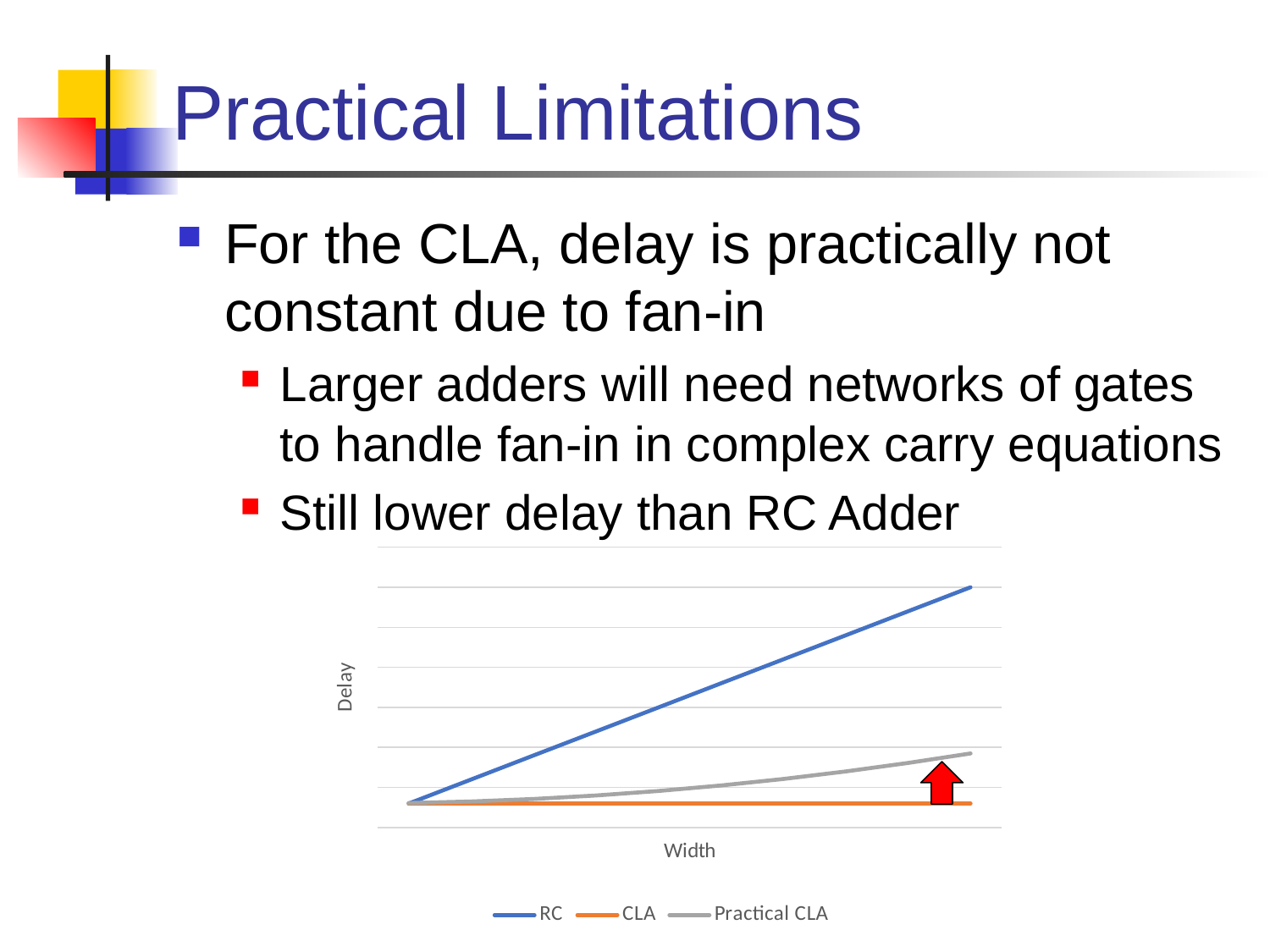
What is the label on the chart's horizontal axis? Width Which series has the highest delay at the largest width shown? RC Does the delay for the Practical CLA series rise, fall, or stay flat as width increases? rise Does the delay for the RC series rise, fall, or stay flat as width increases? rise Does the delay for the CLA series rise, fall, or stay flat as width increases? stay flat Which series has the lowest delay at the largest width shown? CLA At the largest width shown, which has the greater delay: Practical CLA or CLA? Practical CLA What kind of chart is shown on the slide? line chart How many series does the chart's legend list? 3 At the largest width shown, which has the greater delay: RC or Practical CLA? RC What is the label on the chart's vertical axis? Delay What are the three series named in the chart's legend? RC, CLA, Practical CLA